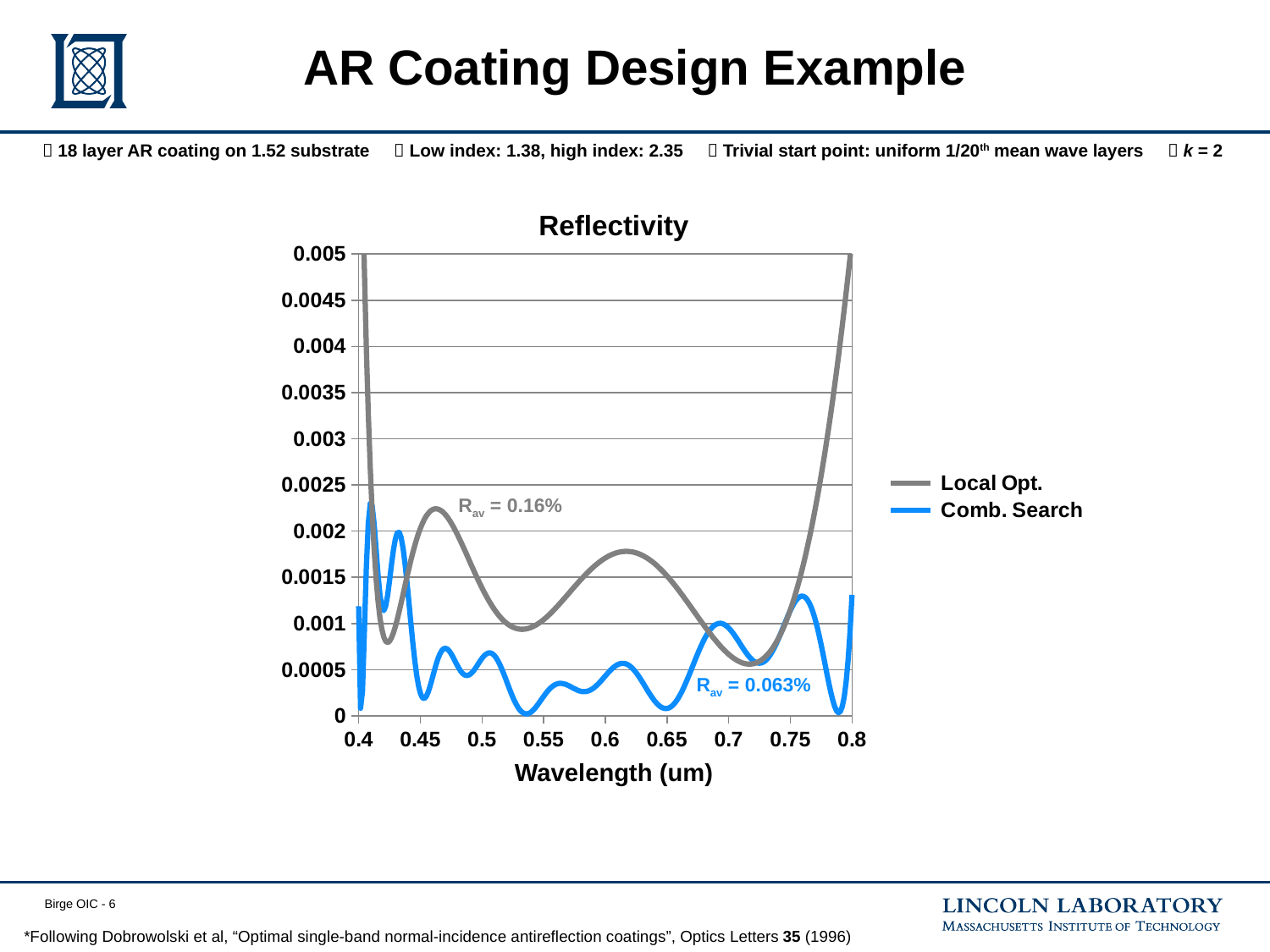
What R_av value is annotated for the Comb. Search series? 0.063% How many series does the legend of the Reflectivity chart list? 2 What is the title of the chart? Reflectivity Which series has the lower annotated R_av value, Local Opt. or Comb. Search? Comb. Search What kind of chart is shown on the slide? line chart Is the Local Opt. reflectivity at 0.6 um greater or less than 0.001? greater What R_av value is annotated for the Local Opt. series? 0.16% Is the Local Opt. reflectivity at 0.7 um greater or less than 0.001? less Is the Comb. Search reflectivity at 0.65 um greater or less than 0.0005? less What is the x-axis label of the Reflectivity chart? Wavelength (um) How many tick labels are shown on the x axis of the Reflectivity chart? 9 At a wavelength of 0.6 um, which series has the higher reflectivity, Local Opt. or Comb. Search? Local Opt.